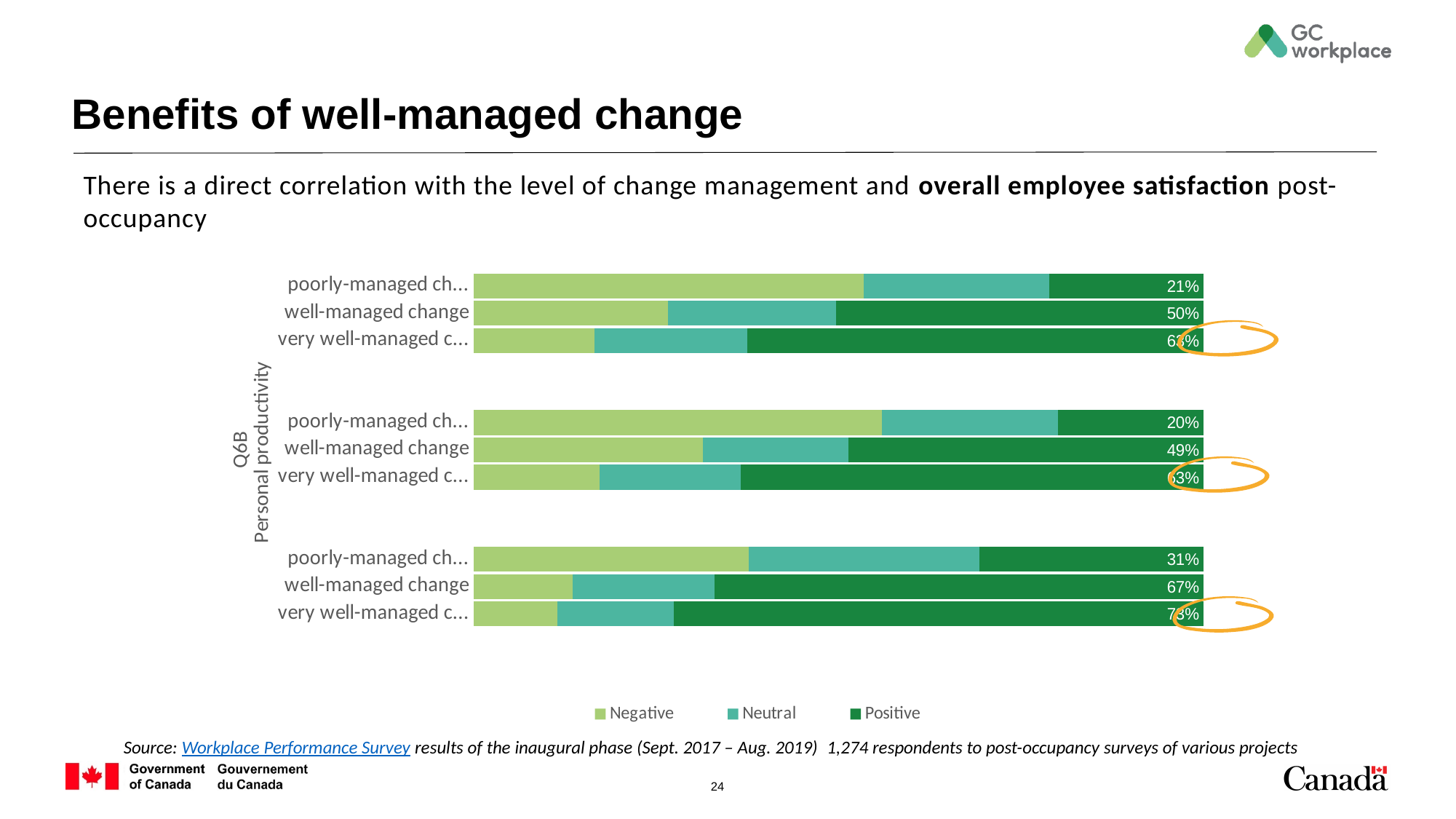
In the top group of bars, what is the Positive percentage for poorly-managed change? 21% In the middle group of bars, what is the Positive percentage for well-managed change? 49% In the bottom group of bars, how many percentage points higher is the Positive share for well-managed change than for poorly-managed change? 36 percentage points In the top group of bars, what is the Positive percentage for well-managed change? 50% In the bottom group of bars, what is the Positive percentage for poorly-managed change? 31% What kind of chart is shown on the slide? Stacked bar chart In the middle group of bars, what is the Positive percentage for poorly-managed change? 20% How many bars are plotted in the chart in total? 9 Which has the larger Positive percentage for well-managed change: the top group of bars or the bottom group of bars? The bottom group (67%) In the bottom group of bars, what is the Positive percentage for well-managed change? 67% How many series does the chart legend list? 3 What are the three series named in the chart legend? Negative, Neutral, Positive